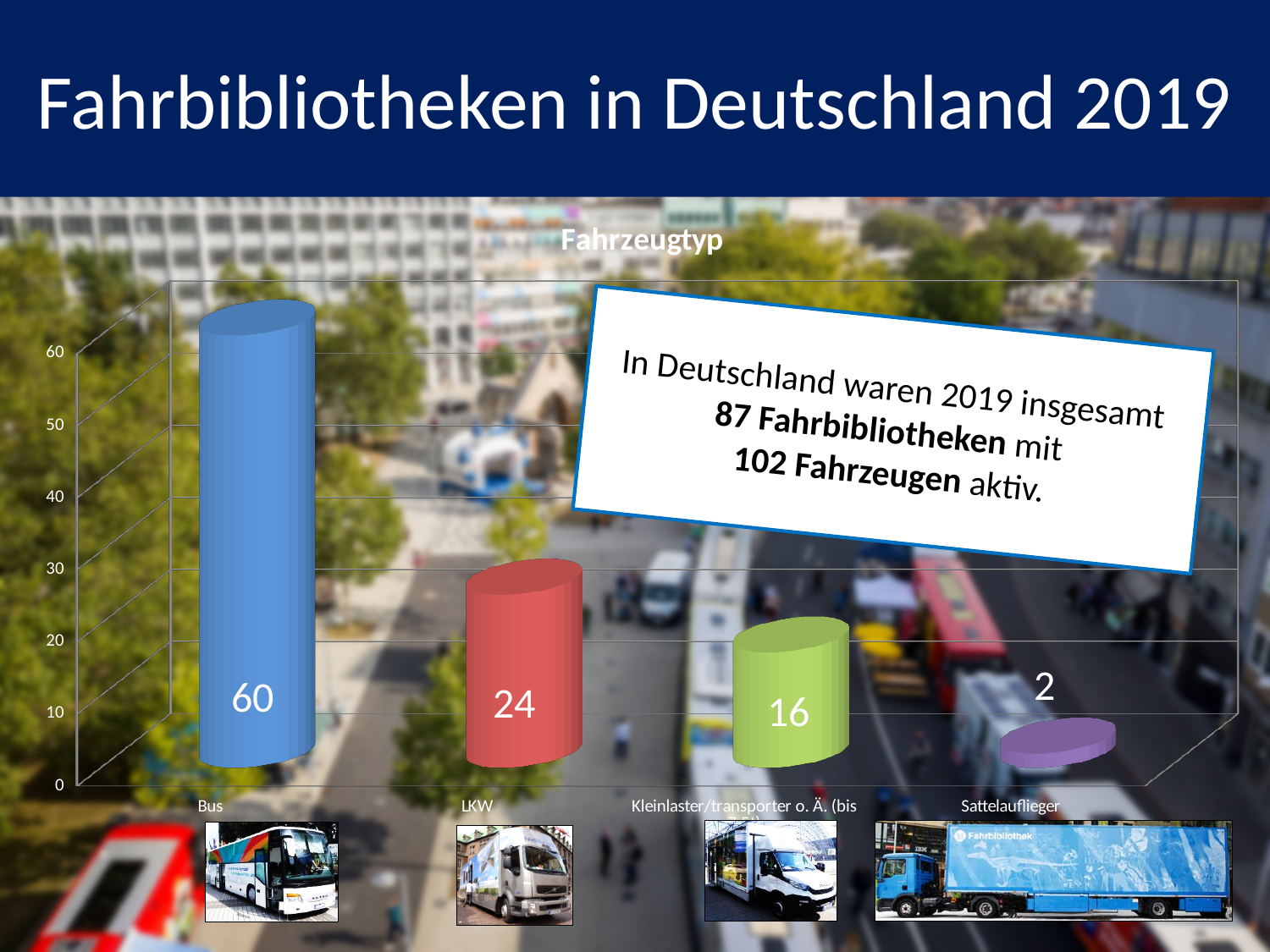
What is the value for LKW? 24 What kind of chart is shown on the slide? bar chart How many vehicle type categories are shown in the chart? 4 Which vehicle type has the highest value? Bus Which is larger, the value for LKW or the value for Kleinlaster/transporter o. Ä.? LKW What is the difference between the values for LKW and Sattelauflieger? 22 Which vehicle type has the lowest value? Sattelauflieger What is the value for Sattelauflieger? 2 What is the value for Kleinlaster/transporter o. Ä.? 16 What is the title of the chart? Fahrzeugtyp What is the difference between the values for Bus and LKW? 36 What is the value for Bus? 60